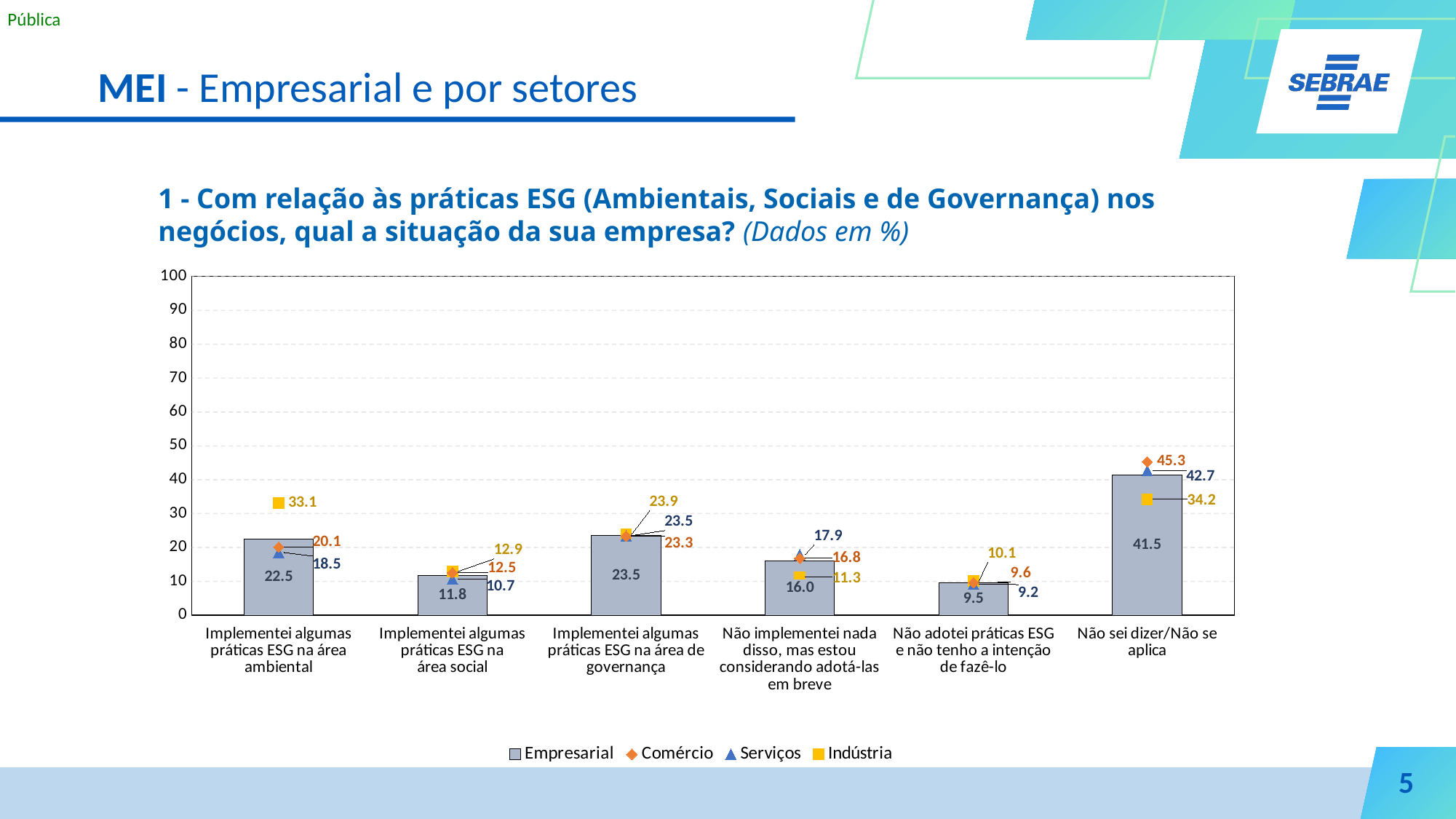
Which category has the highest Empresarial value? Não sei dizer/Não se aplica What is the difference between the Comércio and Indústria values for 'Não sei dizer/Não se aplica'? 11.1 How many response categories are shown on the x axis? 6 Which series is shown with yellow square markers? Indústria For 'Implementei algumas práticas ESG na área ambiental', which is larger: the Indústria value or the Empresarial value? Indústria How many series does the legend list? 4 What is the Indústria value for 'Implementei algumas práticas ESG na área ambiental'? 33.1 What is the Empresarial value for 'Não sei dizer/Não se aplica'? 41.5 Which category has the lowest Empresarial value? Não adotei práticas ESG e não tenho a intenção de fazê-lo What is the Comércio value for 'Não adotei práticas ESG e não tenho a intenção de fazê-lo'? 9.6 What is the Serviços value for 'Não implementei nada disso, mas estou considerando adotá-las em breve'? 17.9 What kind of chart is used for the Empresarial series? Bar chart